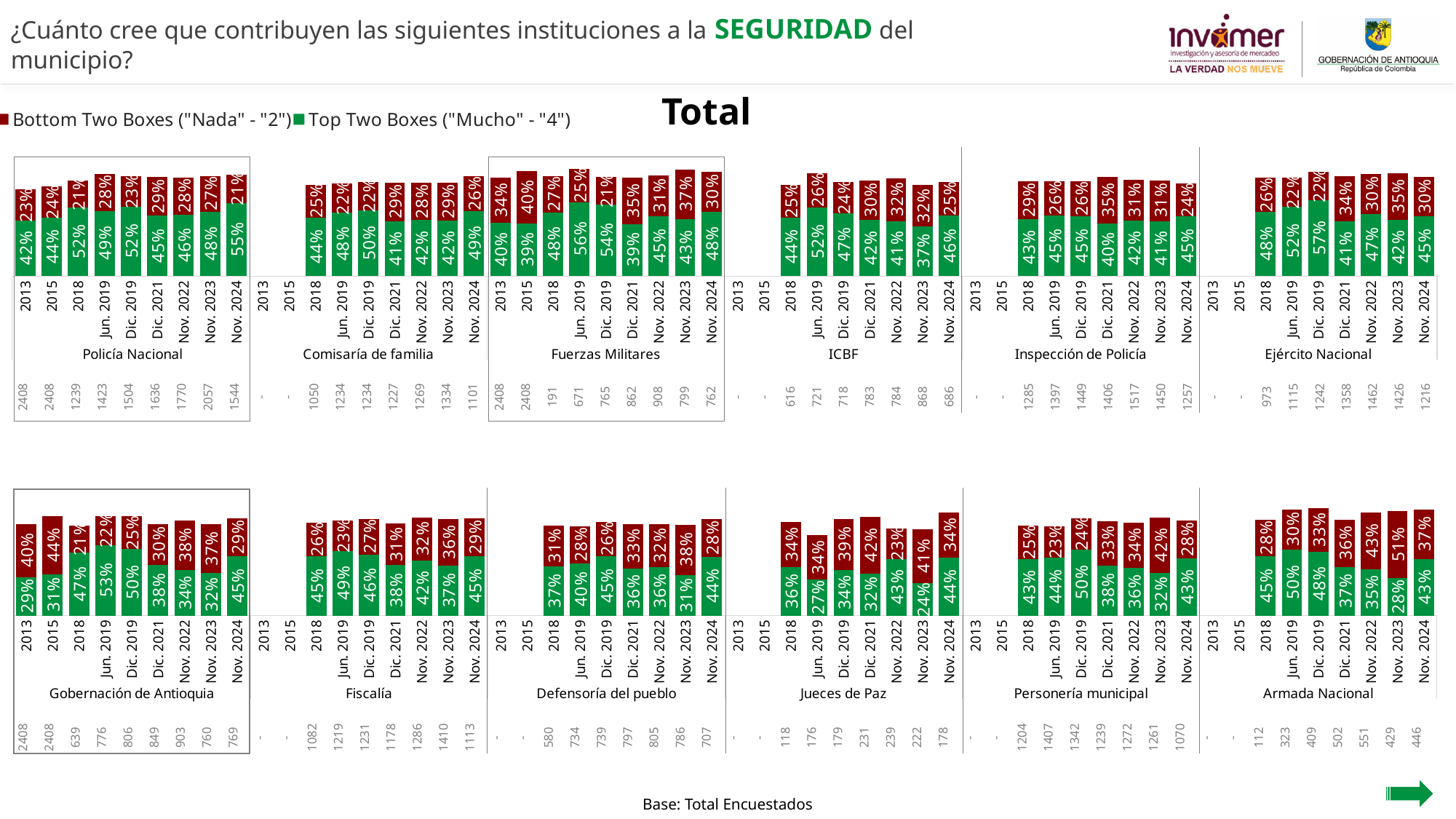
In the ICBF chart, what is the total of the Top Two Boxes and Bottom Two Boxes values for Nov. 2022? 73% In the Jueces de Paz chart, which is larger for Nov. 2023: the Top Two Boxes value or the Bottom Two Boxes value? Bottom Two Boxes In the Comisaría de familia chart, how many periods have bars plotted? 7 What kind of chart is used for each institution on the slide? Stacked bar chart In the Ejército Nacional chart, which period has the highest Top Two Boxes value? Dic. 2019 In the Fuerzas Militares chart, what is the Bottom Two Boxes value for 2015? 40% In the Personería municipal chart, what is the Bottom Two Boxes value for Nov. 2023? 42% Which colour represents the Top Two Boxes ("Mucho" - "4") series? Green How many series does the legend list? 2 In the Gobernación de Antioquia chart, what is the difference between the Top Two Boxes values for Jun. 2019 and 2013? 24% In the Policía Nacional chart, what is the Top Two Boxes value for Nov. 2024? 55% In the Armada Nacional chart, which period has the lowest Top Two Boxes value? Nov. 2023